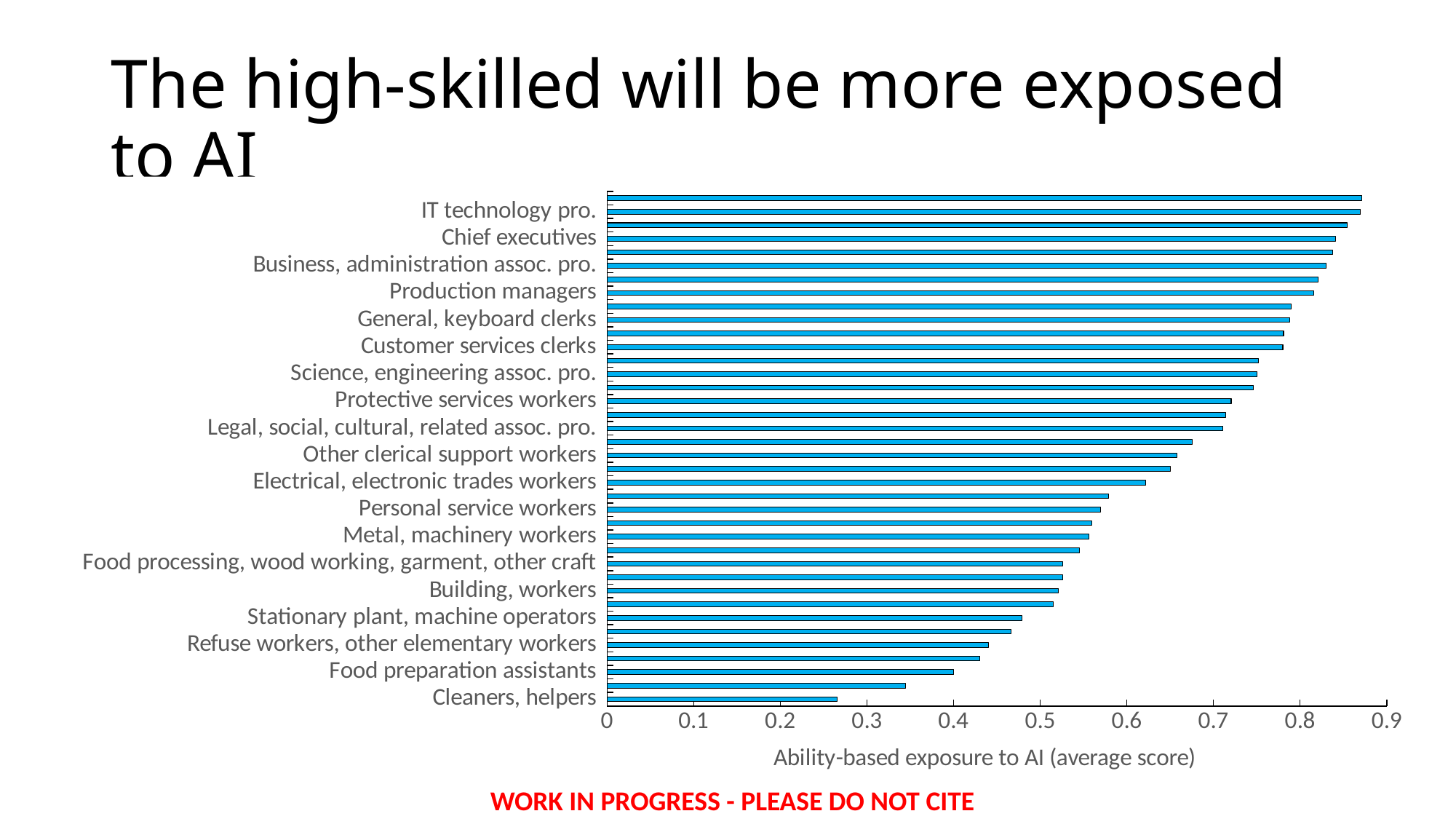
Is the value for Refuse workers, other elementary workers greater or less than 0.5? less Is the value for Chief executives greater or less than 0.8? greater Which has a higher ability-based exposure to AI: Chief executives or Food preparation assistants? Chief executives What is the title of the horizontal axis? Ability-based exposure to AI (average score) Is the value for Science, engineering assoc. pro. greater or less than 0.7? greater What kind of chart is shown on the slide? bar chart Do the bar values increase or decrease going from the top of the chart to the bottom? decrease Which occupation group has the lowest ability-based exposure to AI? Cleaners, helpers